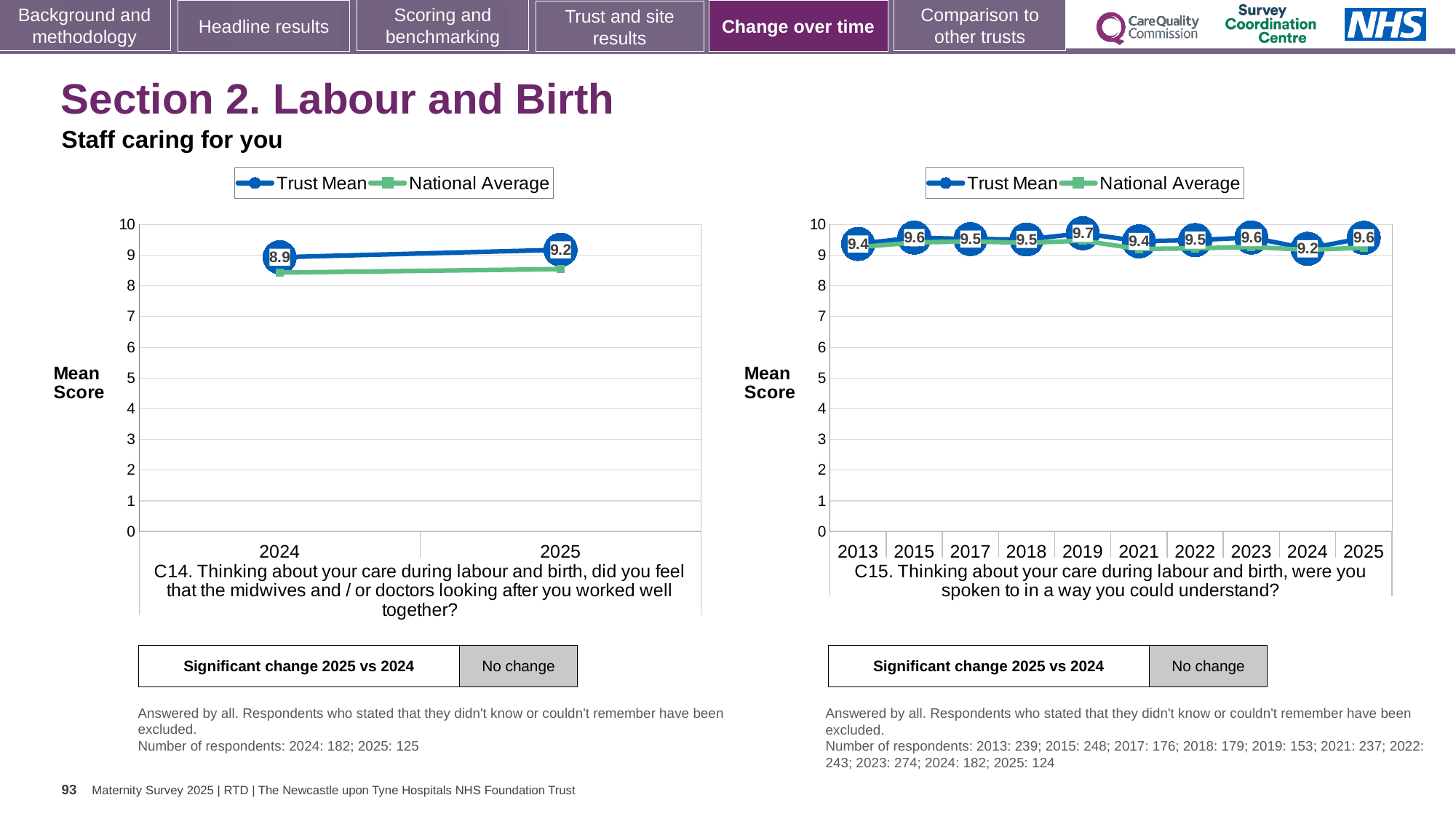
In the left chart (C14), is the National Average for 2024 greater or less than 8? greater In the right chart (C15), which year has the highest Trust Mean? 2019 What kind of chart is the left chart (C14)? line chart In the left chart (C14), by how much did the Trust Mean change from 2024 to 2025? 0.3 In the right chart (C15), which year has the lowest Trust Mean? 2024 In the left chart (C14), what is the Trust Mean for 2024? 8.9 How many series does the legend of the right chart (C15) list? 2 In the right chart (C15), what is the Trust Mean for 2021? 9.4 In the right chart (C15), which is larger, the Trust Mean for 2019 or for 2024? 2019 In the left chart (C14), what is the Trust Mean for 2025? 9.2 In the right chart (C15), how many years are plotted on the x axis? 10 In the left chart (C14), does the Trust Mean rise or fall from 2024 to 2025? rise